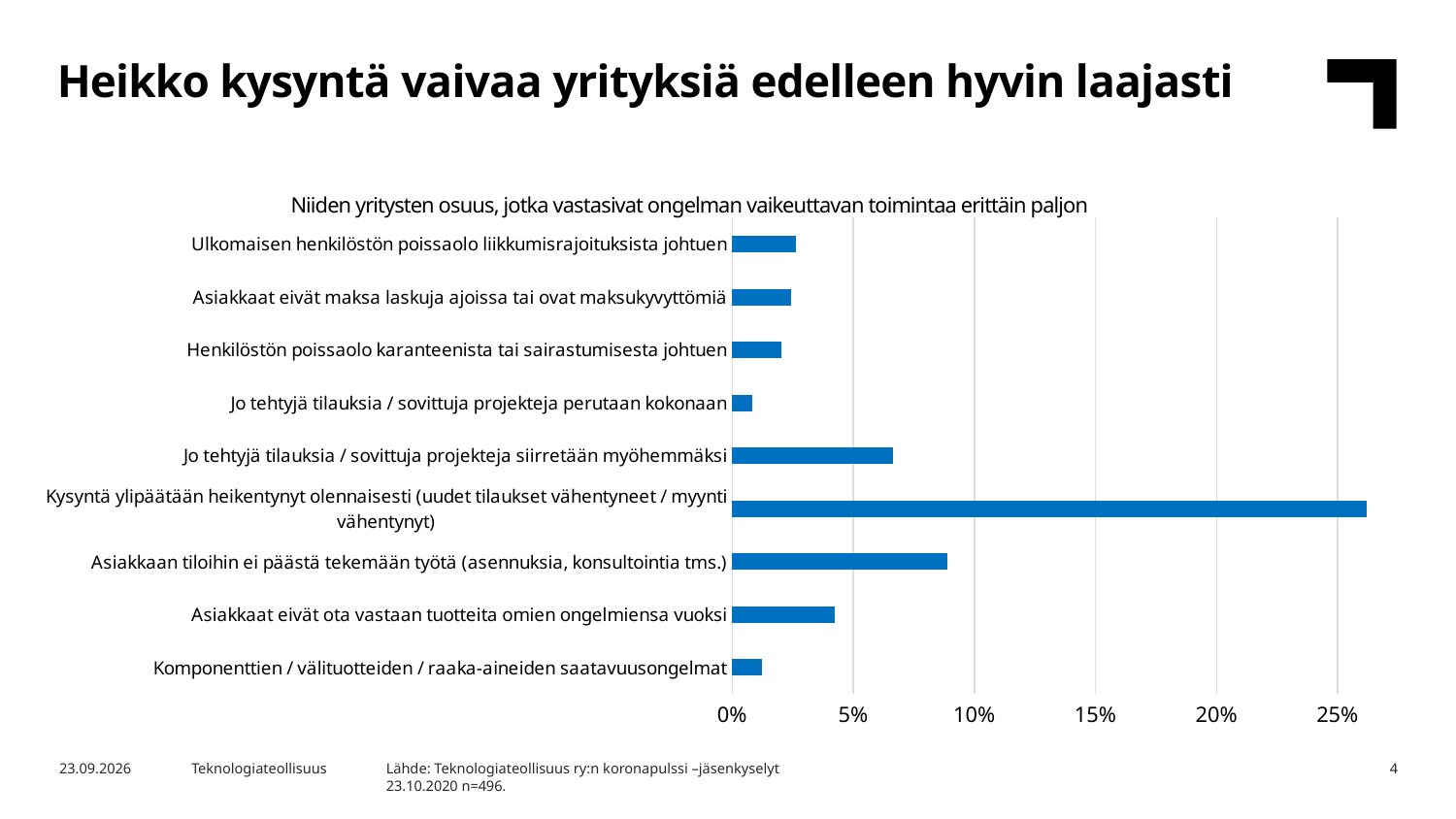
Is the value for 'Kysyntä ylipäätään heikentynyt olennaisesti' greater or less than 25%? greater What kind of chart is shown on the slide? bar chart Is the value for 'Asiakkaan tiloihin ei päästä tekemään työtä' greater or less than 10%? less What is the highest value shown on the chart's horizontal axis? 25% Which is larger: the value for 'Asiakkaan tiloihin ei päästä tekemään työtä' or the value for 'Jo tehtyjä tilauksia / sovittuja projekteja siirretään myöhemmäksi'? Asiakkaan tiloihin ei päästä tekemään työtä Which is larger: the value for 'Komponenttien / välituotteiden / raaka-aineiden saatavuusongelmat' or the value for 'Asiakkaat eivät ota vastaan tuotteita omien ongelmiensa vuoksi'? Asiakkaat eivät ota vastaan tuotteita omien ongelmiensa vuoksi Is the value for 'Jo tehtyjä tilauksia / sovittuja projekteja siirretään myöhemmäksi' greater or less than 5%? greater How many categories are plotted in the chart? 9 Which category has the highest value in the chart? Kysyntä ylipäätään heikentynyt olennaisesti (uudet tilaukset vähentyneet / myynti vähentynyt) What is the title of the chart? Niiden yritysten osuus, jotka vastasivat ongelman vaikeuttavan toimintaa erittäin paljon Which category has the lowest value in the chart? Jo tehtyjä tilauksia / sovittuja projekteja perutaan kokonaan